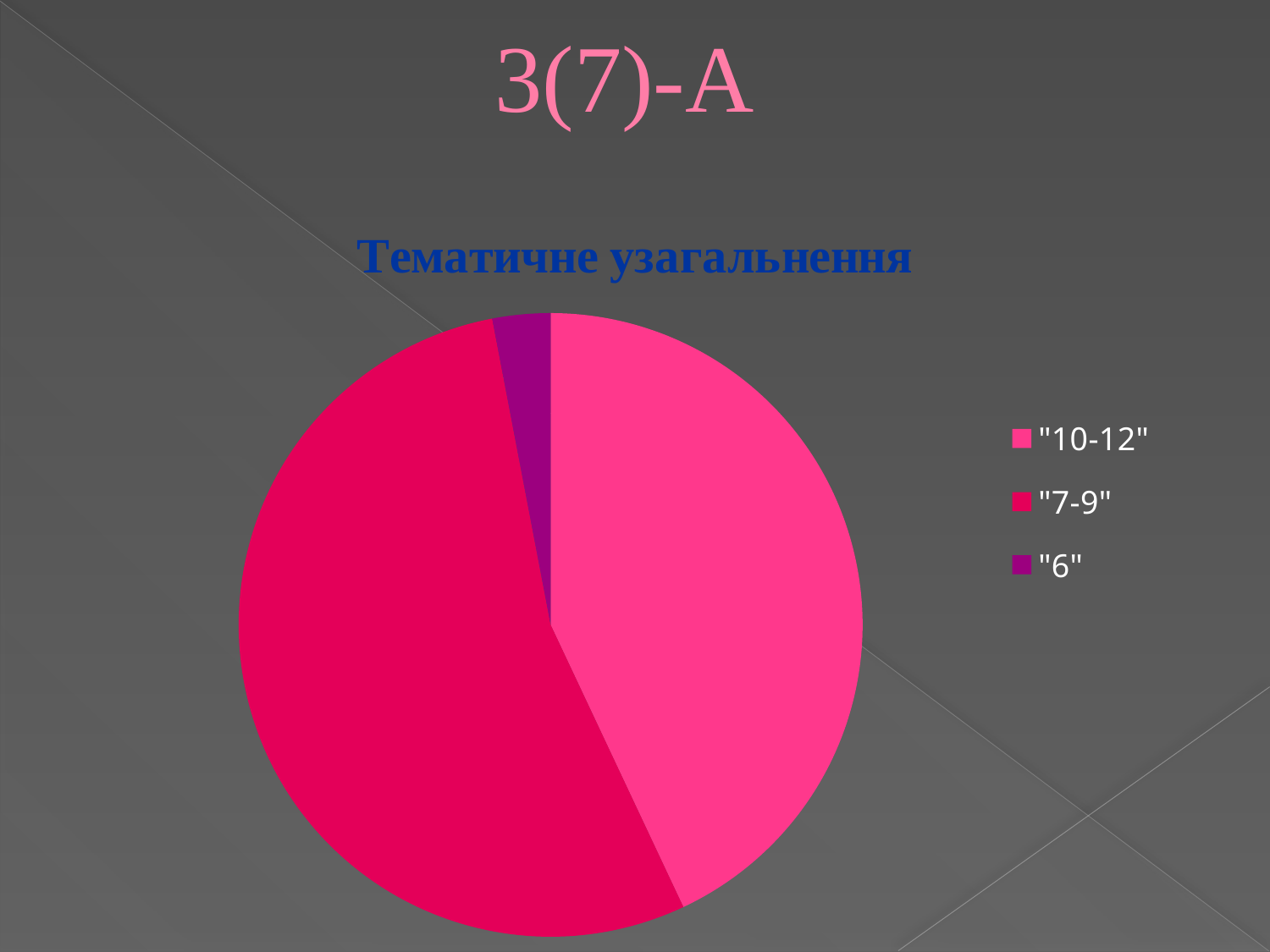
How many entries does the legend list? 3 Which slice is larger, "7-9" or "6"? "7-9" How many slices does the pie chart have? 3 What kind of chart is shown on the slide? pie chart Which category has the smallest slice of the pie? "6" Which slice is larger, "10-12" or "7-9"? "7-9" What is the title of the chart? Тематичне узагальнення Which legend entry is shown in purple? "6" Which category has the largest slice of the pie? "7-9"